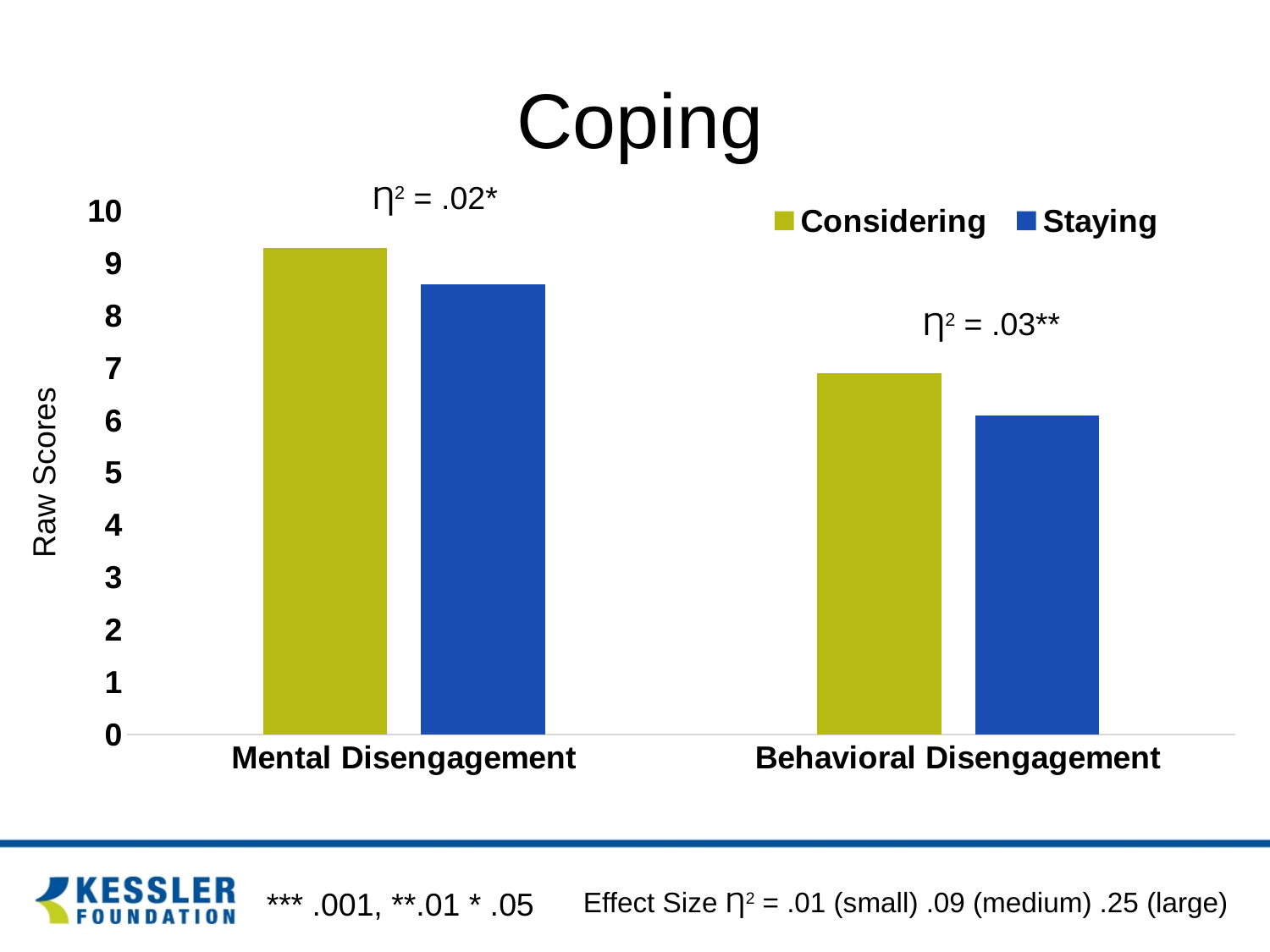
Is the Staying value for Mental Disengagement greater or less than 9? less What effect size is annotated above the Mental Disengagement bars? η² = .02* What kind of chart is shown on the slide? bar chart Which series has the higher value for Behavioral Disengagement, Considering or Staying? Considering How many categories are shown on the x axis? 2 Which series has the higher value for Mental Disengagement, Considering or Staying? Considering How many series does the legend list? 2 Is the Considering value for Mental Disengagement greater or less than 9? greater Is the Staying value for Behavioral Disengagement greater or less than 7? less Which category has the lowest Staying bar? Behavioral Disengagement What is the label on the y axis? Raw Scores Which category has the highest Considering bar? Mental Disengagement